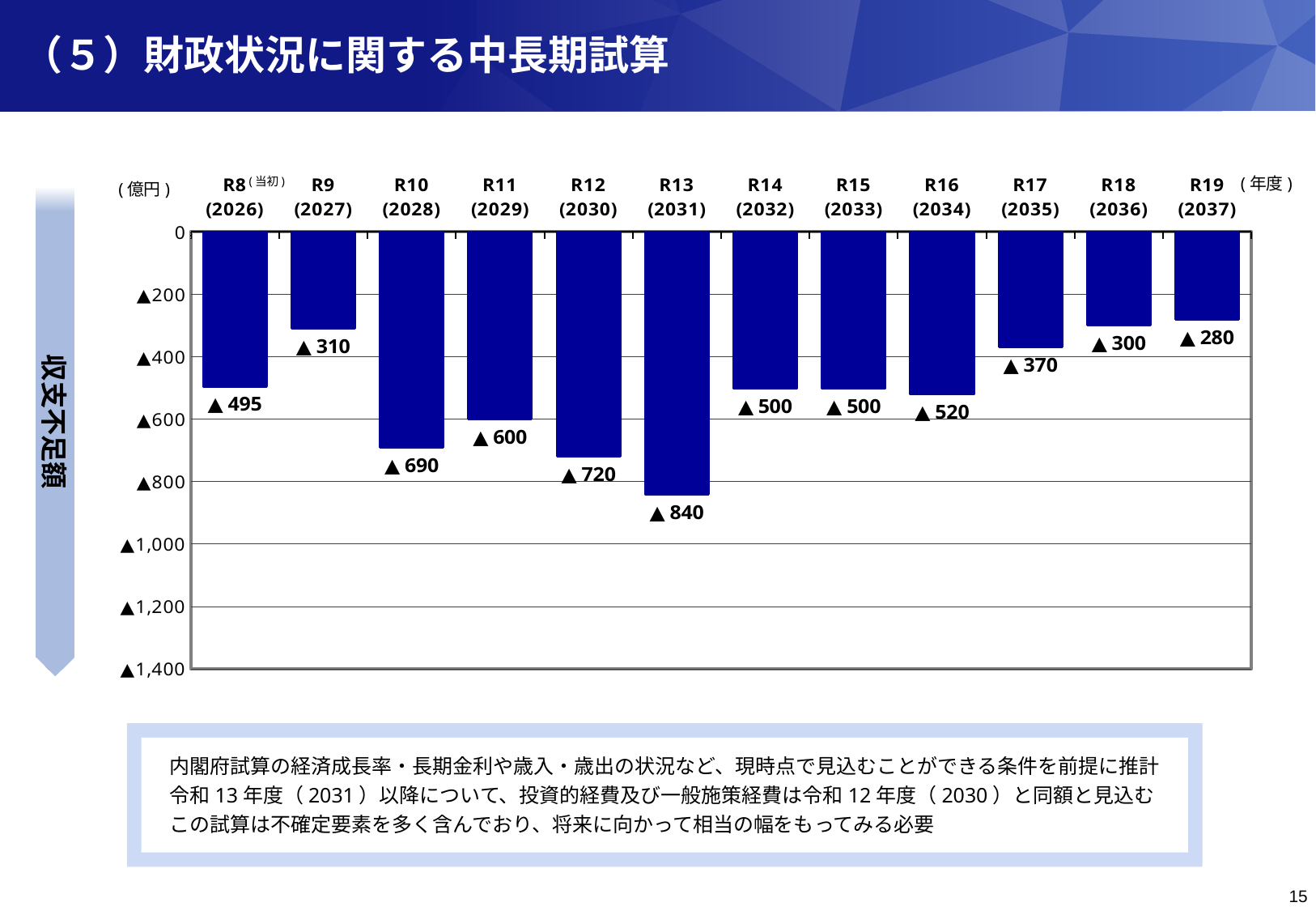
Which fiscal year has the largest shortfall (the longest bar)? R13 (2031) What unit is shown at the top left of the chart's vertical axis? 億円 How many fiscal years are plotted on the chart? 12 Do the bars get shorter or longer from R16 (2034) to R19 (2037)? Shorter Which fiscal year has the smallest shortfall (the shortest bar)? R19 (2037) What is the value shown for R13 (2031)? ▲ 840 What is the difference between the values for R10 (2028) and R11 (2029)? 90 What is the value shown for R19 (2037)? ▲ 280 What is the difference between the values for R13 (2031) and R12 (2030)? 120 What kind of chart is shown on the slide? Bar chart What is the value shown for R8 (2026)? ▲ 495 Which bar is longer, R9 (2027) or R17 (2035)? R17 (2035)